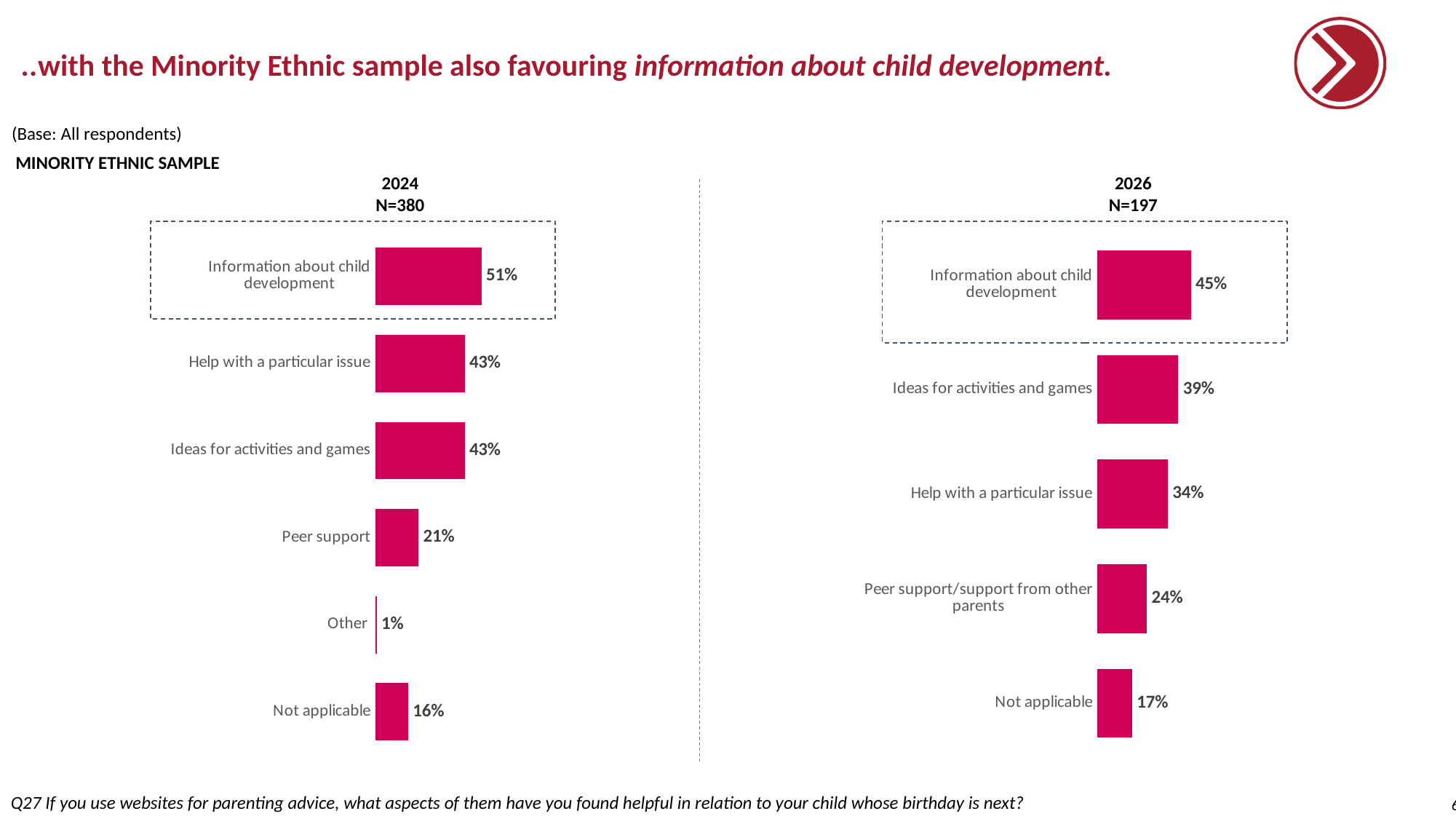
In the 2026 chart, which is larger: Help with a particular issue or Peer support/support from other parents? Help with a particular issue In the 2026 chart, which category has the lowest value? Not applicable In the 2026 chart, which category has the highest value? Information about child development In the 2024 chart, which category has the lowest value? Other In the 2024 chart, what is the value for Information about child development? 51% What type of chart is the 2026 chart? Bar chart In the 2026 chart, what is the difference between Ideas for activities and games and Help with a particular issue? 5 percentage points How many categories are shown in the 2024 chart? 6 In the 2024 chart, what is the difference between Information about child development and Help with a particular issue? 8 percentage points In the 2026 chart, what is the value for Not applicable? 17% In the 2024 chart, what is the value for Peer support? 21% In the 2026 chart, what is the value for Ideas for activities and games? 39%